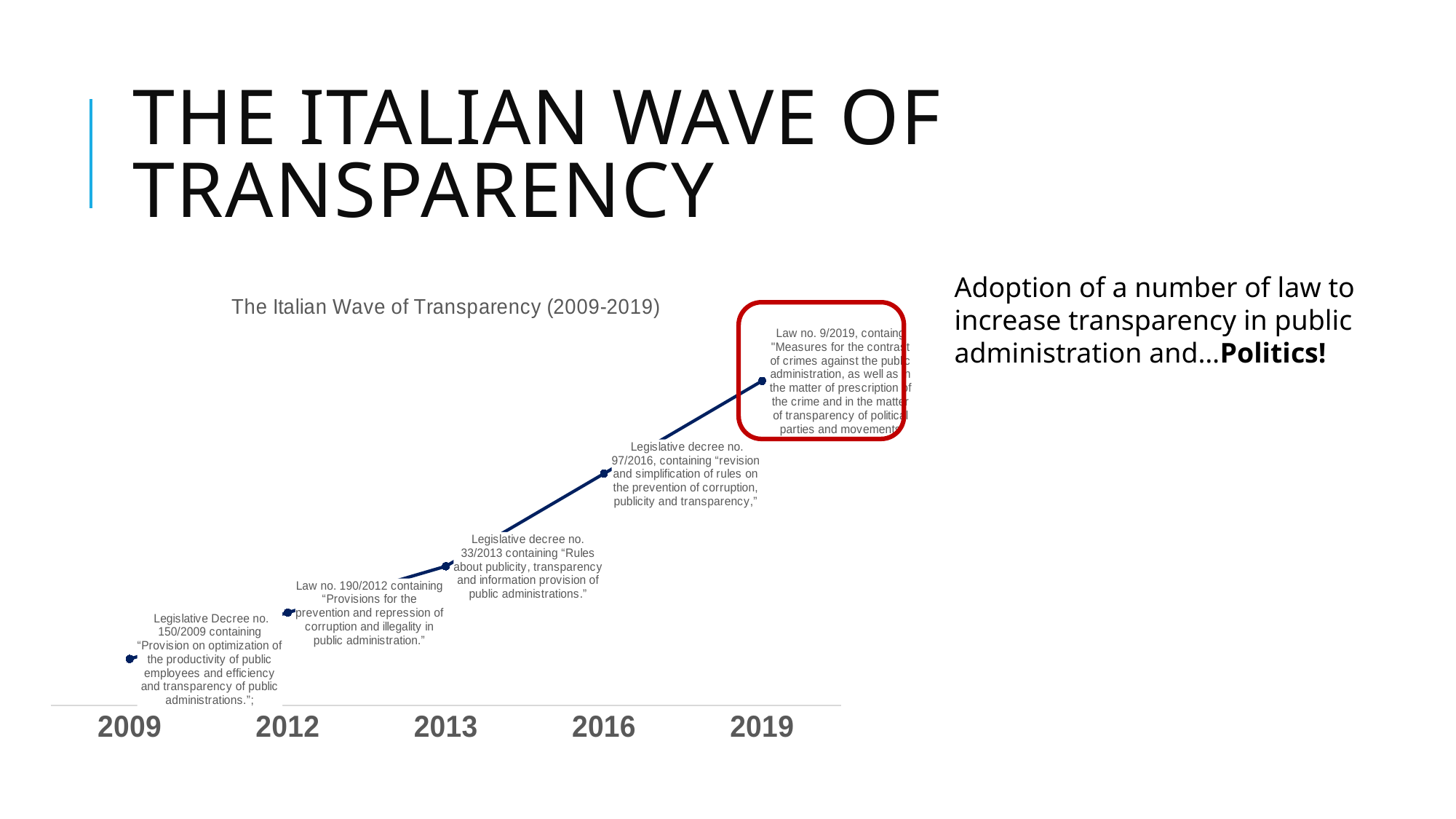
Do the plotted points rise or fall from 2009 to 2019? Rise Is the point for 2016 higher or lower than the point for 2013? Higher Which years are shown on the x axis of the chart? 2009, 2012, 2013, 2016, 2019 What is the title of the chart? The Italian Wave of Transparency (2009-2019) Which year has the lowest point on the chart? 2009 Which year has the highest point on the chart? 2019 How many data points are plotted on the chart? 5 Which legislative decree is labelled at the 2016 point on the chart? Legislative decree no. 97/2016 Which law is labelled at the 2019 point on the chart? Law no. 9/2019 What kind of chart is shown on the slide? Line chart Which law is labelled at the 2012 point on the chart? Law no. 190/2012 Which legislative decree is labelled at the 2013 point on the chart? Legislative decree no. 33/2013